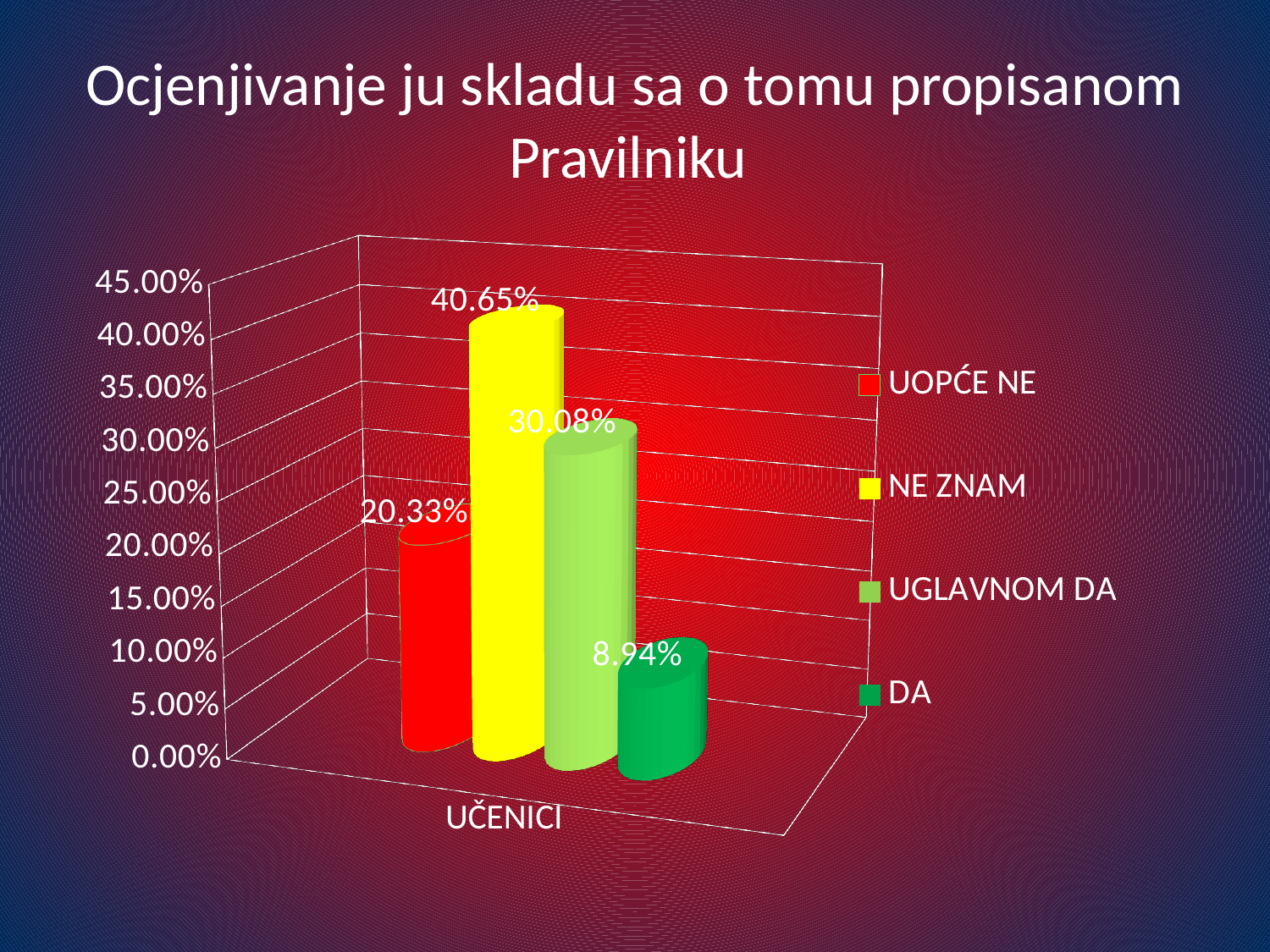
What is the value for NE ZNAM in the UČENICI category? 40.65% How many series does the legend list? 4 Is the value for UGLAVNOM DA greater or less than 25.00%? greater What is the value for UOPĆE NE? 20.33% What is the difference between the NE ZNAM and UGLAVNOM DA values? 10.57% Which is larger, UOPĆE NE or DA? UOPĆE NE Which series has the highest value? NE ZNAM Which series has the lowest value? DA What kind of chart is shown on the slide? bar chart What is the value for UGLAVNOM DA? 30.08% What is the category label on the x axis? UČENICI What is the value for DA? 8.94%